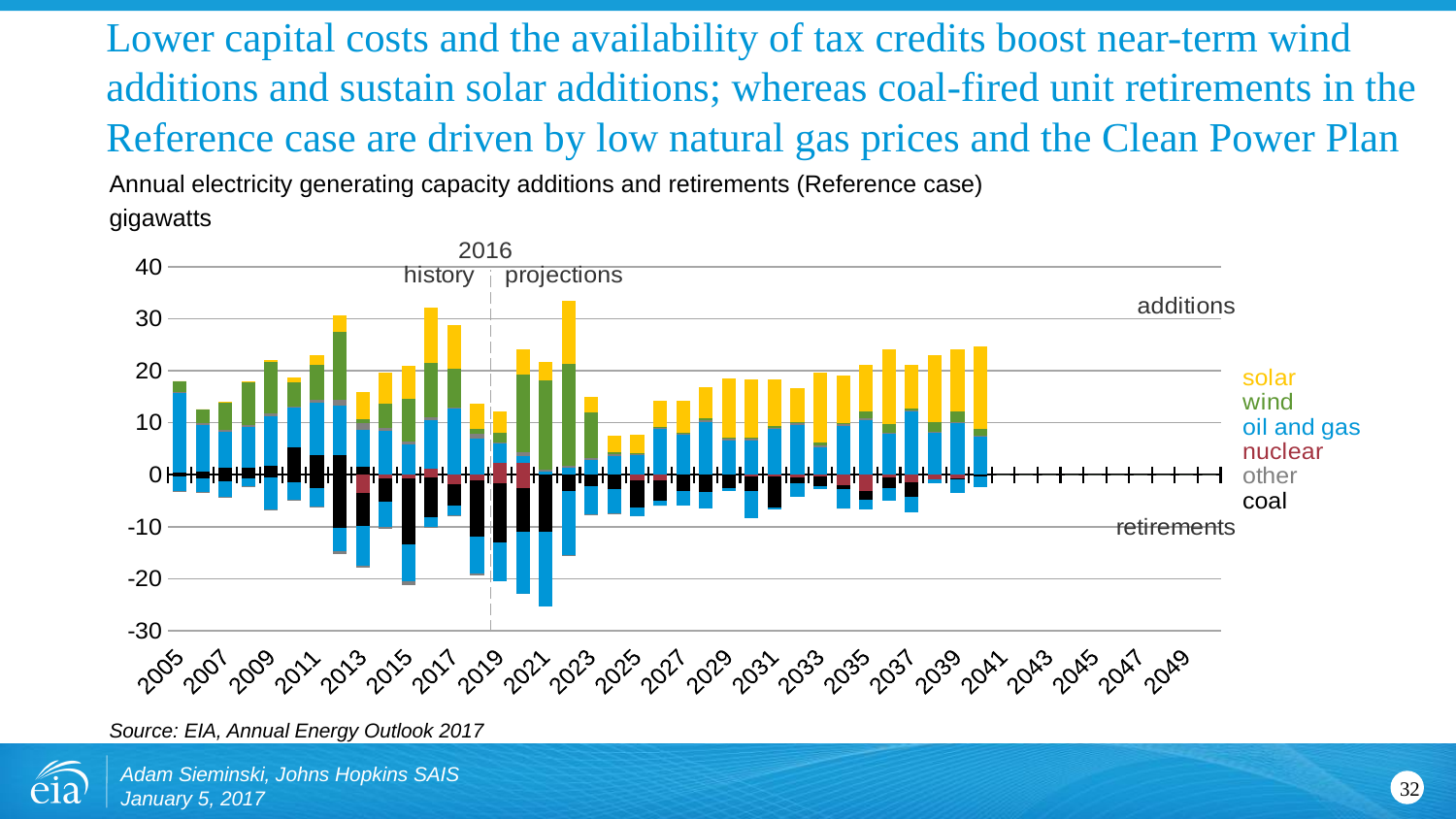
Do the projected annual additions generally rise or fall between 2025 and 2040? rise Which year marks the boundary between history and projections on the chart? 2016 Is the tallest additions bar greater or less than 30 gigawatts? greater Does any bar on the chart exceed 40 gigawatts? No Is the largest retirements bar (most negative) greater or less than -30 gigawatts? greater What kind of chart is shown on the slide? Stacked bar chart Which series are listed in the legend? solar, wind, oil and gas, nuclear, other, coal How many series does the legend list? 6